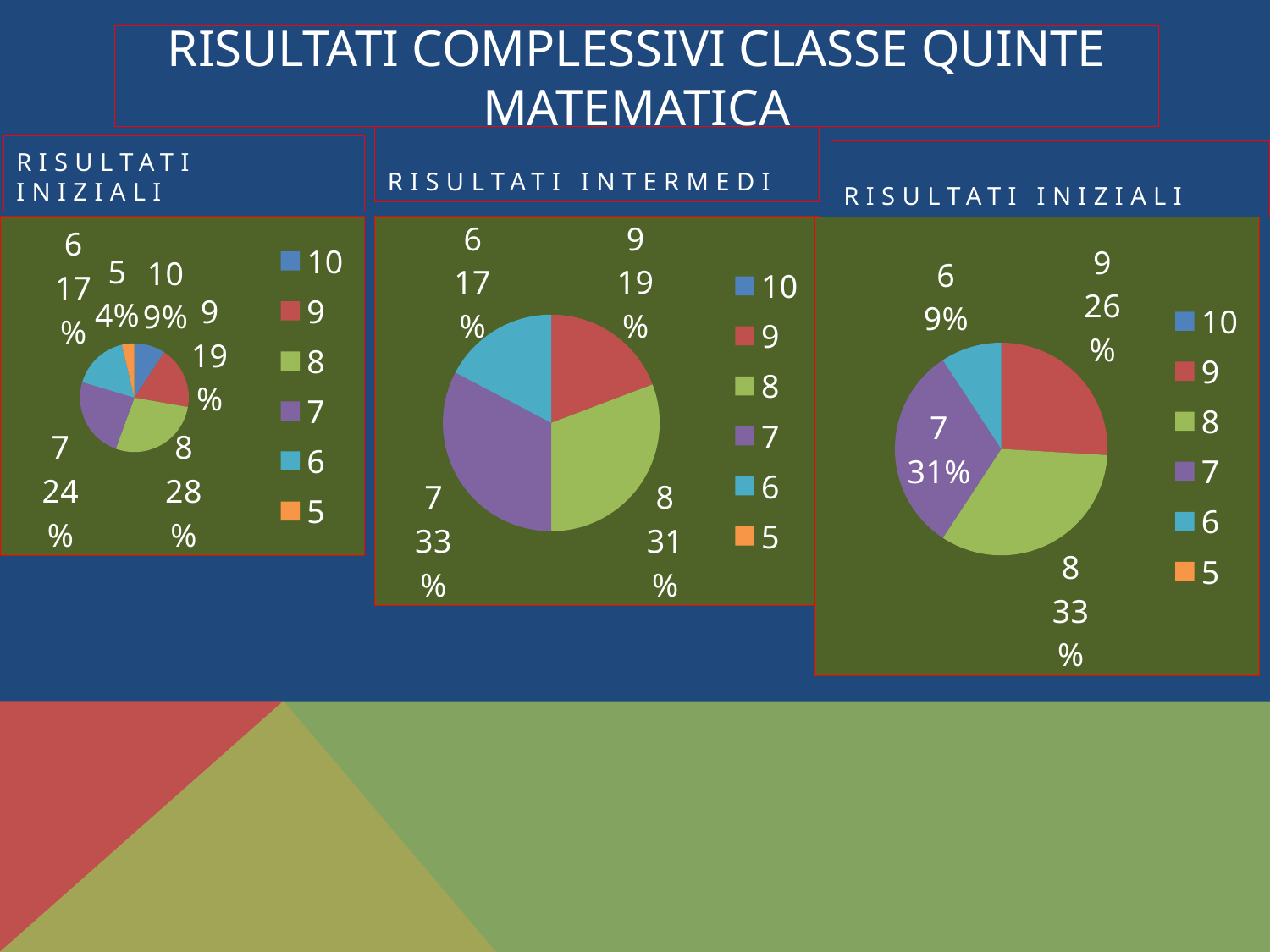
How many entries does the legend of the middle pie chart list? 6 In the middle pie chart (RISULTATI INTERMEDI), what share does category 7 have? 33% In the right pie chart, what share does category 9 have? 26% In the left pie chart, which category has the smallest share? 5 In the right pie chart, which category has the largest share? 8 In the right pie chart, which has the larger share, category 7 or category 6? 7 What type of chart is used in the middle panel (RISULTATI INTERMEDI)? Pie chart In the middle pie chart (RISULTATI INTERMEDI), what is the difference in percentage points between category 8 and category 9? 12 In the left pie chart, what share does category 8 have? 28% In the left pie chart, what share does category 5 have? 4% What is the title of the middle chart panel? RISULTATI INTERMEDI